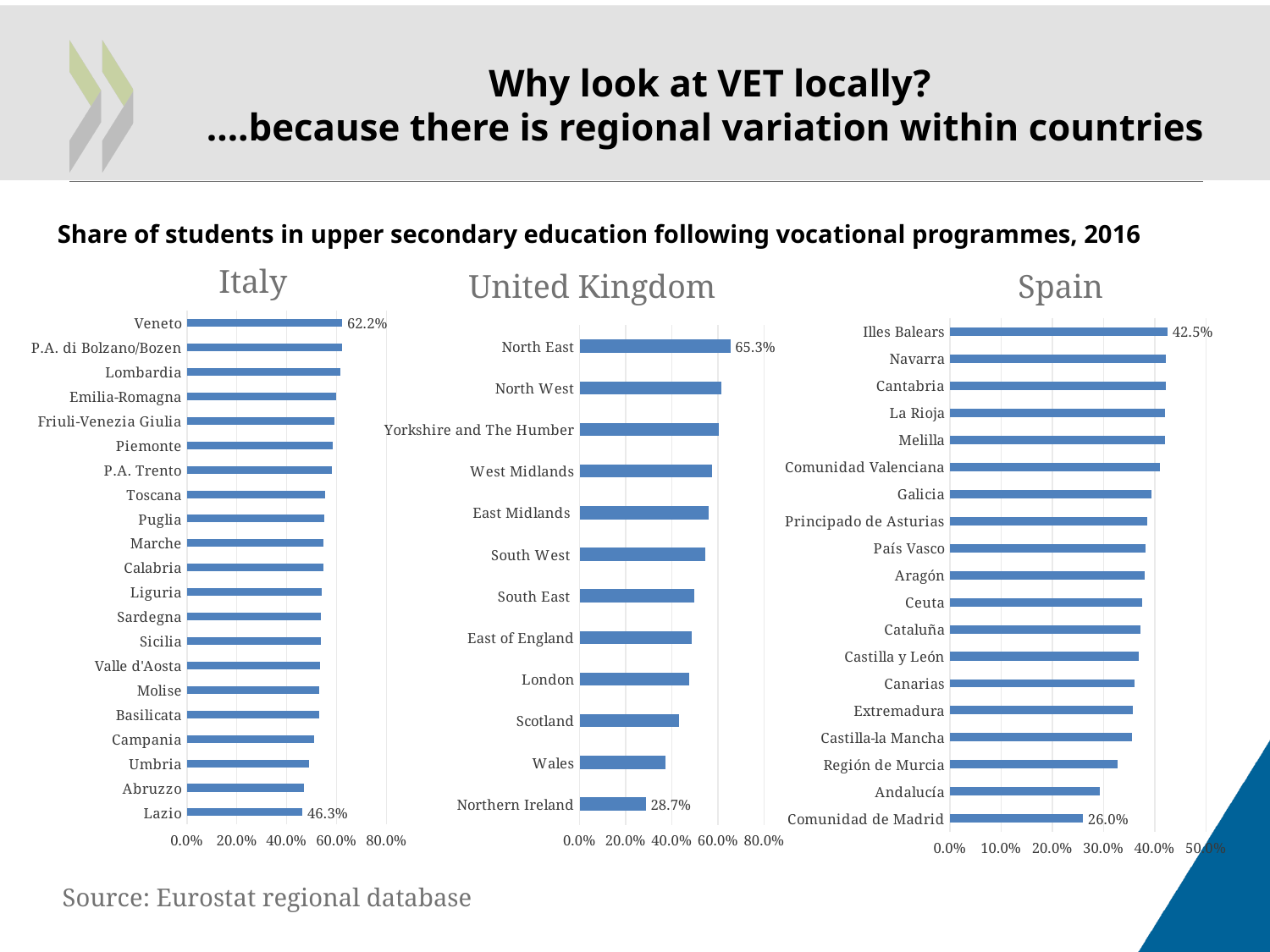
On the Italy chart, what is the value for Veneto? 62.2% On the Spain chart, what is the value for Comunidad de Madrid? 26.0% On the United Kingdom chart, what is the value for Northern Ireland? 28.7% On the United Kingdom chart, what is the difference between the values for North East and Northern Ireland? 36.6 percentage points On the Spain chart, which region has the lowest share? Comunidad de Madrid How many regions are shown on the United Kingdom chart? 12 On the United Kingdom chart, is the value for Wales greater or less than 40.0%? less On the Spain chart, is the value for Región de Murcia greater or less than 30.0%? greater On the United Kingdom chart, which region has the highest share? North East What type of chart is used for the Italy data? Bar chart On the Italy chart, what is the difference between the values for Veneto and Lazio? 15.9 percentage points How many regions are shown on the Spain chart? 19